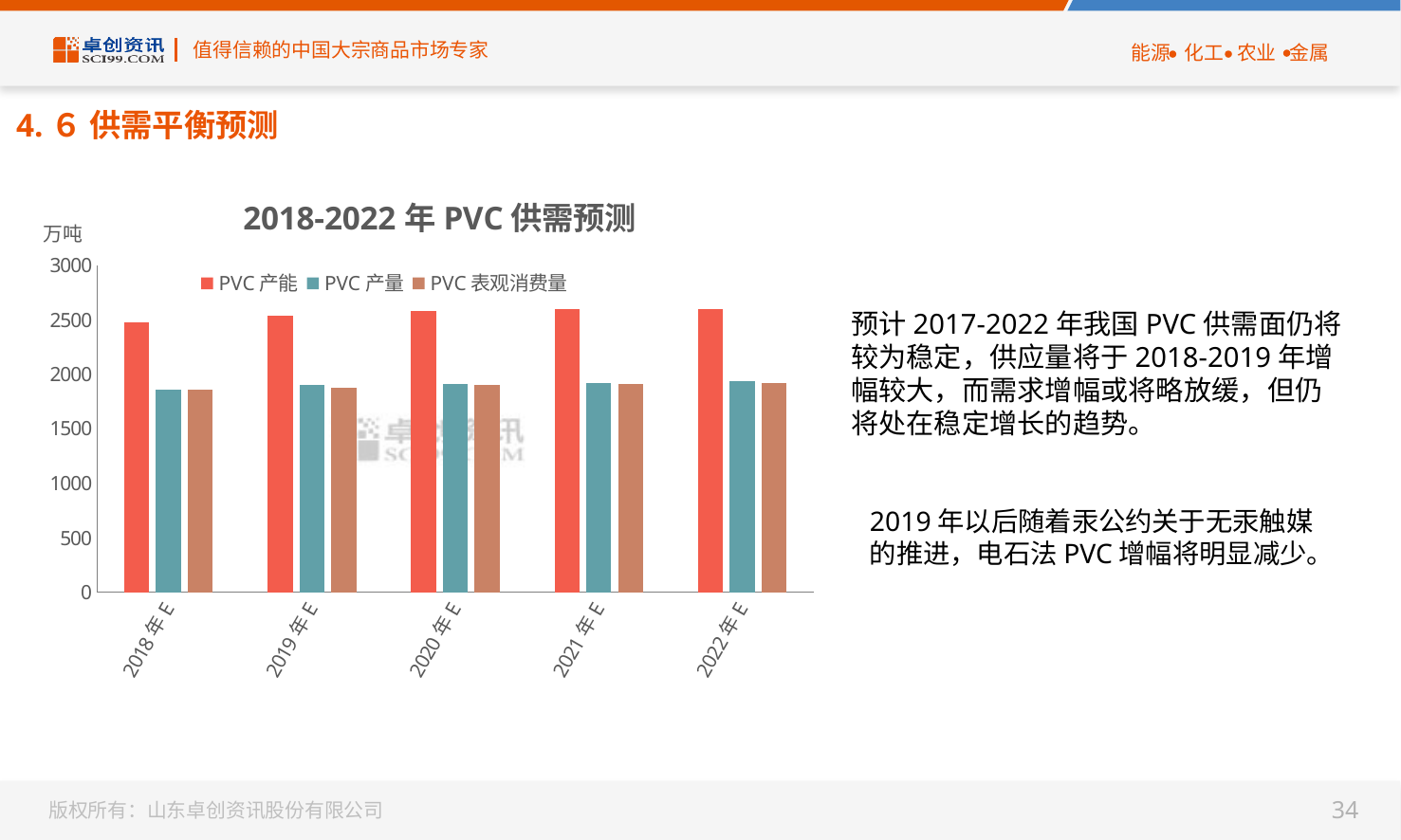
What kind of chart is shown on the slide? bar chart Is the value of PVC 产量 for 2018 年 E greater or less than 2000? less Is the value of PVC 产能 for 2022 年 E greater or less than 2500? greater How many series does the chart legend list? 3 Is the value of PVC 表观消费量 for 2020 年 E greater or less than 1500? greater How many year categories are shown on the x axis of the chart? 5 Which year has the lowest value for PVC 产能? 2018 年 E In 2019 年 E, which is larger: PVC 产能 or PVC 产量? PVC 产能 What is the title of the chart? 2018-2022 年 PVC 供需预测 Does the PVC 产能 series generally rise or fall from 2018 年 E to 2022 年 E? rise Which series is shown in red in the chart? PVC 产能